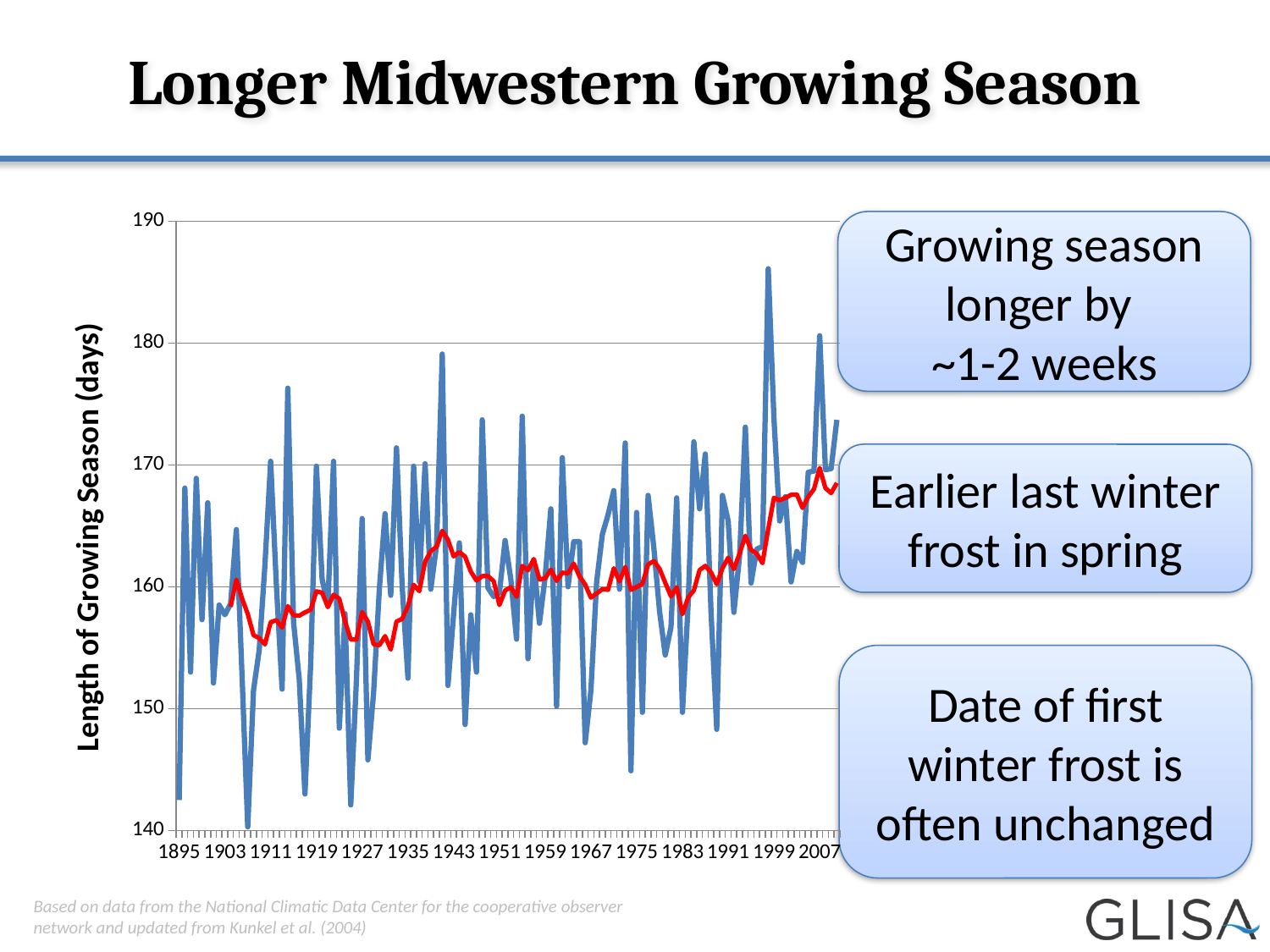
What is the highest value shown on the vertical axis? 190 How many lines are plotted on the chart? 2 What is the lowest value shown on the vertical axis? 140 What is the label on the vertical axis of the chart? Length of Growing Season (days) Is the red line's value at the right end of the chart (around 2007) greater or less than 160? greater Is the red line's value around 1927 greater or less than 160? less What kind of chart is shown on the slide? line chart Does the red smoothed line generally rise or fall from 1895 to 2007? rise Is the highest peak of the blue line greater or less than 180? greater What is the first year shown on the horizontal axis? 1895 What is the title of the chart on the slide? Longer Midwestern Growing Season